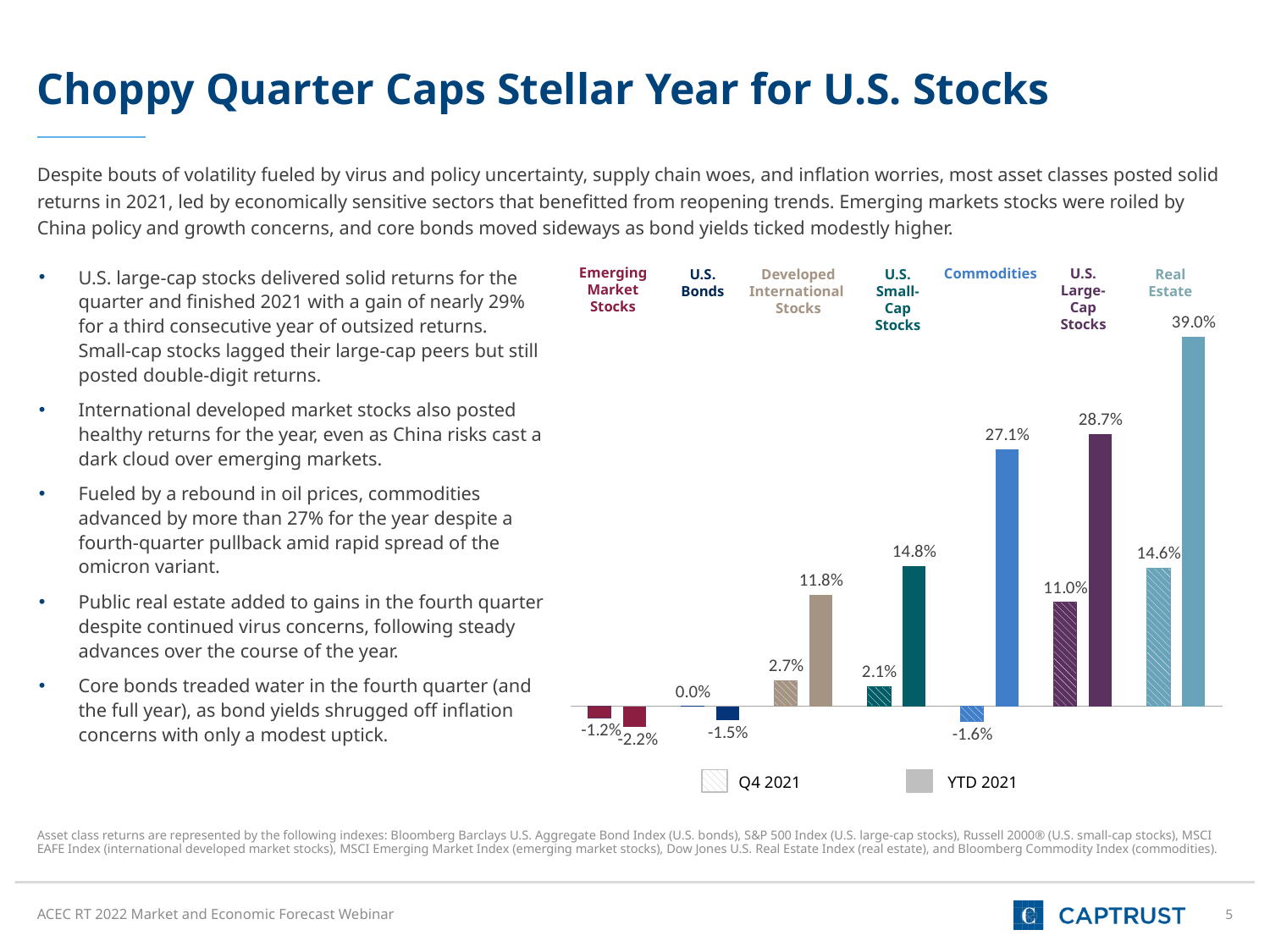
What are the two series named in the chart legend? Q4 2021 and YTD 2021 Which asset class has the lowest YTD 2021 return? Emerging Market Stocks What is the Q4 2021 return for U.S. Large-Cap Stocks? 11.0% How many series does the chart legend list? 2 How many asset classes are shown in the chart? 7 What kind of chart is shown on the slide? Bar chart What is the difference between the YTD 2021 return for U.S. Large-Cap Stocks and U.S. Small-Cap Stocks? 13.9% What is the Q4 2021 return for U.S. Bonds? 0.0% What is the YTD 2021 return for Commodities? 27.1% Which asset class has the highest YTD 2021 return? Real Estate Which is larger, the Q4 2021 return for Developed International Stocks or for U.S. Small-Cap Stocks? Developed International Stocks What is the YTD 2021 return for Real Estate? 39.0%